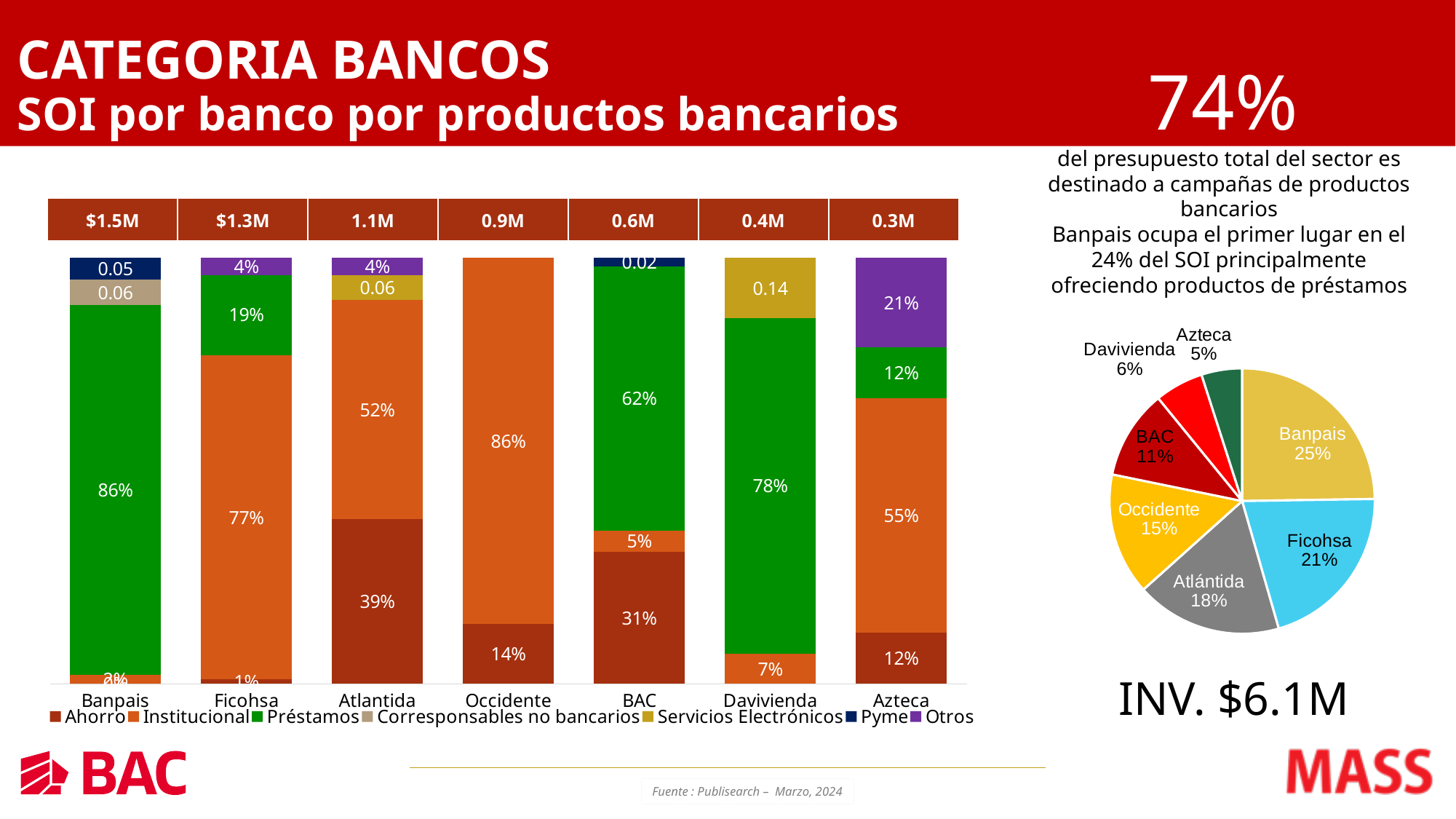
In the pie chart, which bank has the smallest slice? Azteca In the stacked bar chart, what is the Otros share for Azteca? 21% In the pie chart, what share does Atlántida have? 18% How many series does the legend of the stacked bar chart list? 7 In the stacked bar chart, what percentage of Occidente's SOI goes to Institucional? 86% In the stacked bar chart, what is the Ahorro share for Atlantida? 39% How many banks are shown on the x axis of the stacked bar chart? 7 In the stacked bar chart, which bank has the highest Préstamos share? Banpais What type of chart is the chart on the right side of the slide? Pie chart In the stacked bar chart, which is larger: the Ahorro share for BAC or the Ahorro share for Occidente? BAC In the stacked bar chart, what is the Préstamos share for BAC? 62% In the stacked bar chart, what is the difference between Ficohsa's Institucional share and its Préstamos share? 58%